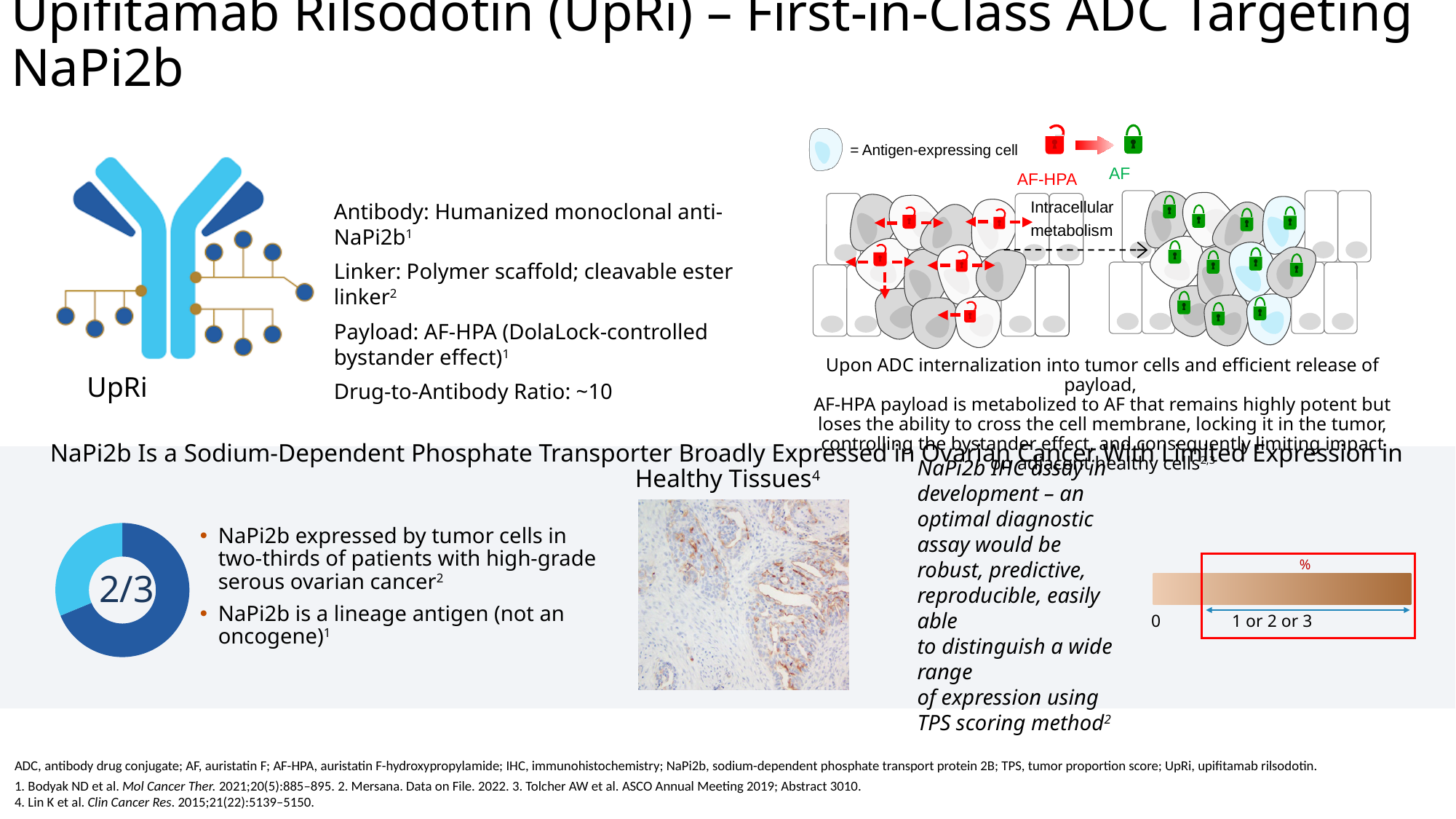
What kind of chart is shown at the bottom left of the slide next to the NaPi2b bullet points? Donut (pie) chart What value is printed in the centre of the donut chart at the bottom left of the slide? 2/3 What two colours are used for the segments of the donut chart at the bottom left of the slide? Dark blue and light blue How many segments does the donut chart at the bottom left of the slide have? 2 According to the donut chart and its accompanying text, what share of patients with high-grade serous ovarian cancer have tumor cells expressing NaPi2b? 2/3 In the donut chart at the bottom left of the slide, which segment is larger, the dark blue one or the light blue one? Dark blue In the donut chart at the bottom left of the slide, which segment is the smallest? Light blue